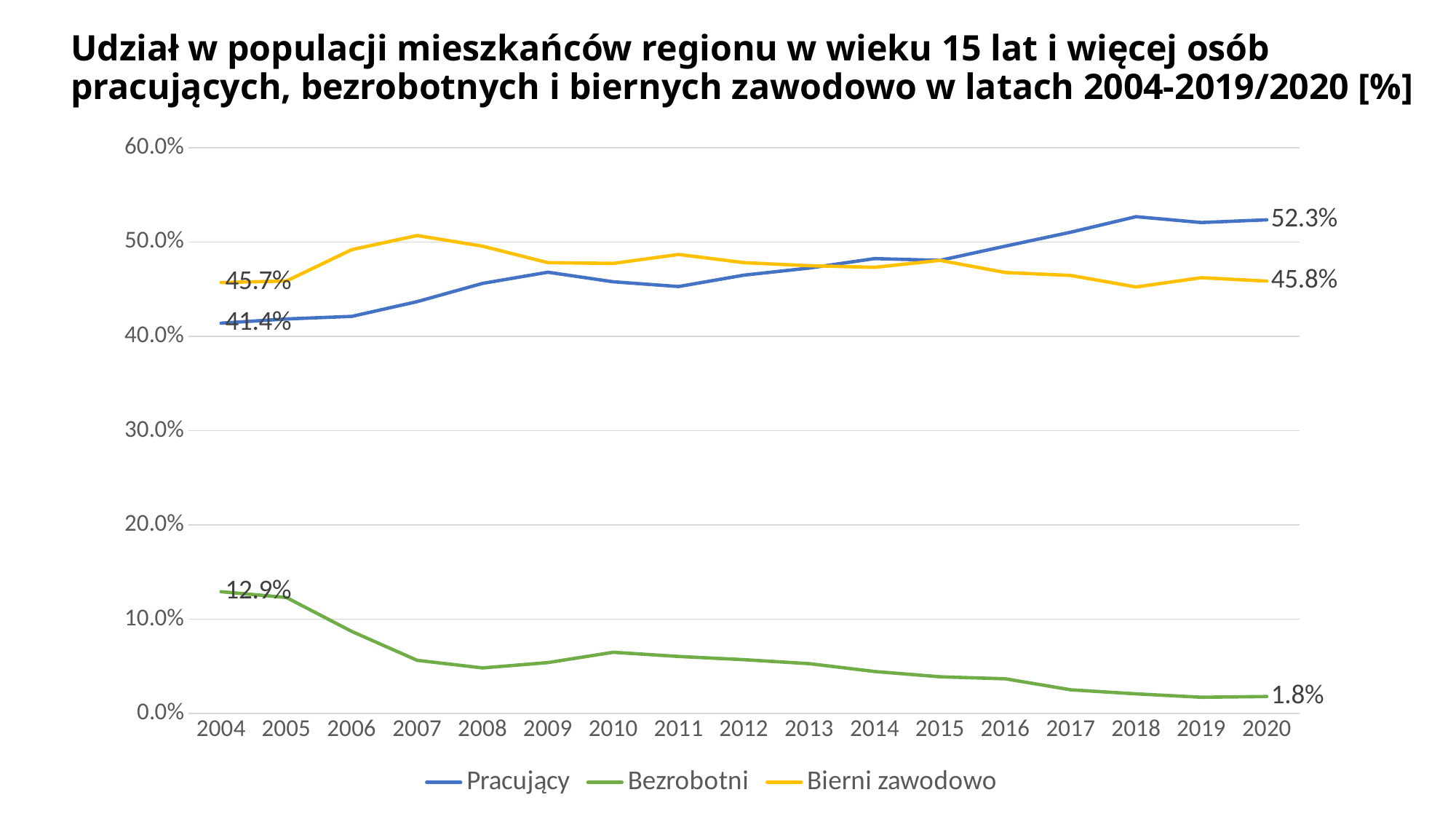
What kind of chart is shown on the slide? line chart What is the value for Bezrobotni in 2020? 1.8% Is the value for Bierni zawodowo in 2007 greater or less than 50.0%? greater How many years are plotted along the x axis? 17 How many series does the legend list? 3 By how many percentage points did the Bezrobotni value fall between 2004 and 2020? 11.1 percentage points In 2020, which is larger: Pracujący or Bierni zawodowo? Pracujący What is the value for Pracujący in 2004? 41.4% What is the value for Bierni zawodowo in 2004? 45.7% By how many percentage points did the Pracujący value change between 2004 and 2020? 10.9 percentage points What is the value for Pracujący in 2020? 52.3% Does the Bezrobotni line rise or fall from 2004 to 2020? fall